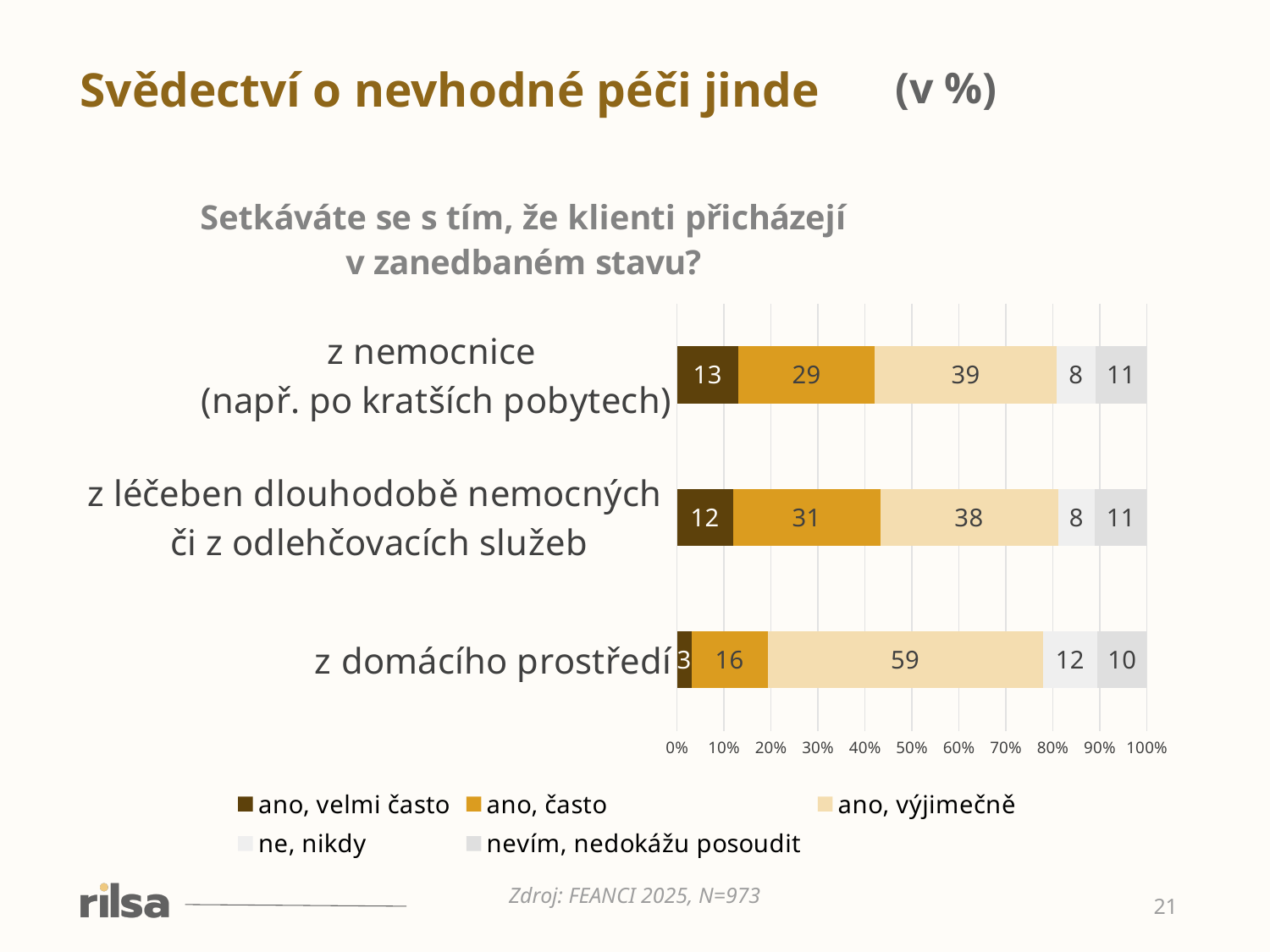
What is the value of "ne, nikdy" for "z domácího prostředí"? 12 Which category has the highest value for "ano, výjimečně"? z domácího prostředí Which is larger: the "ano, výjimečně" value for "z nemocnice (např. po kratších pobytech)" or for "z léčeben dlouhodobě nemocných či z odlehčovacích služeb"? z nemocnice (např. po kratších pobytech) Which category has the lowest value for "ano, velmi často"? z domácího prostředí What is the value of "ano, velmi často" for "z nemocnice (např. po kratších pobytech)"? 13 What is the difference between the "ano, často" values for "z léčeben dlouhodobě nemocných či z odlehčovacích služeb" and "z nemocnice (např. po kratších pobytech)"? 2 What is the value of "ano, výjimečně" for "z domácího prostředí"? 59 How many categories are shown on the chart? 3 What is the total of the stacked bar for "z domácího prostředí"? 100 What is the value of "ano, často" for "z léčeben dlouhodobě nemocných či z odlehčovacích služeb"? 31 How many series does the legend list? 5 What kind of chart is shown on the slide? stacked bar chart